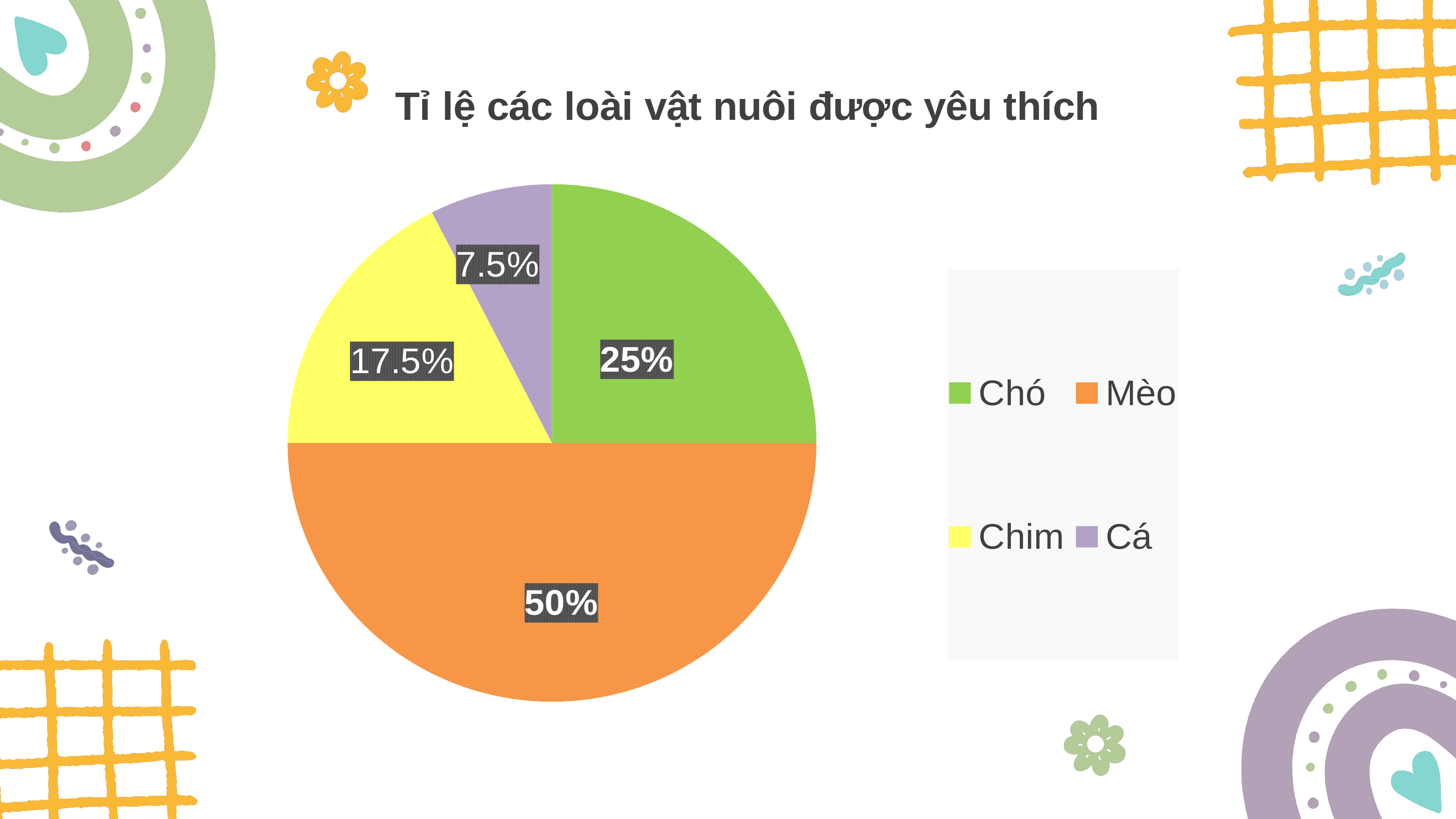
What is the difference in percentage points between Chim and Cá? 10 What percentage of the pie is Mèo? 50% What percentage of the pie is Chim? 17.5% What is the difference in percentage points between Mèo and Chó? 25 Which category has the largest share of the pie? Mèo What percentage of the pie is Chó? 25% Which is larger, the share for Chó or the share for Chim? Chó Which category has the smallest share of the pie? Cá What is the title of the chart? Tỉ lệ các loài vật nuôi được yêu thích How many categories does the legend list? 4 What percentage of the pie is Cá? 7.5% What kind of chart is shown on the slide? Pie chart